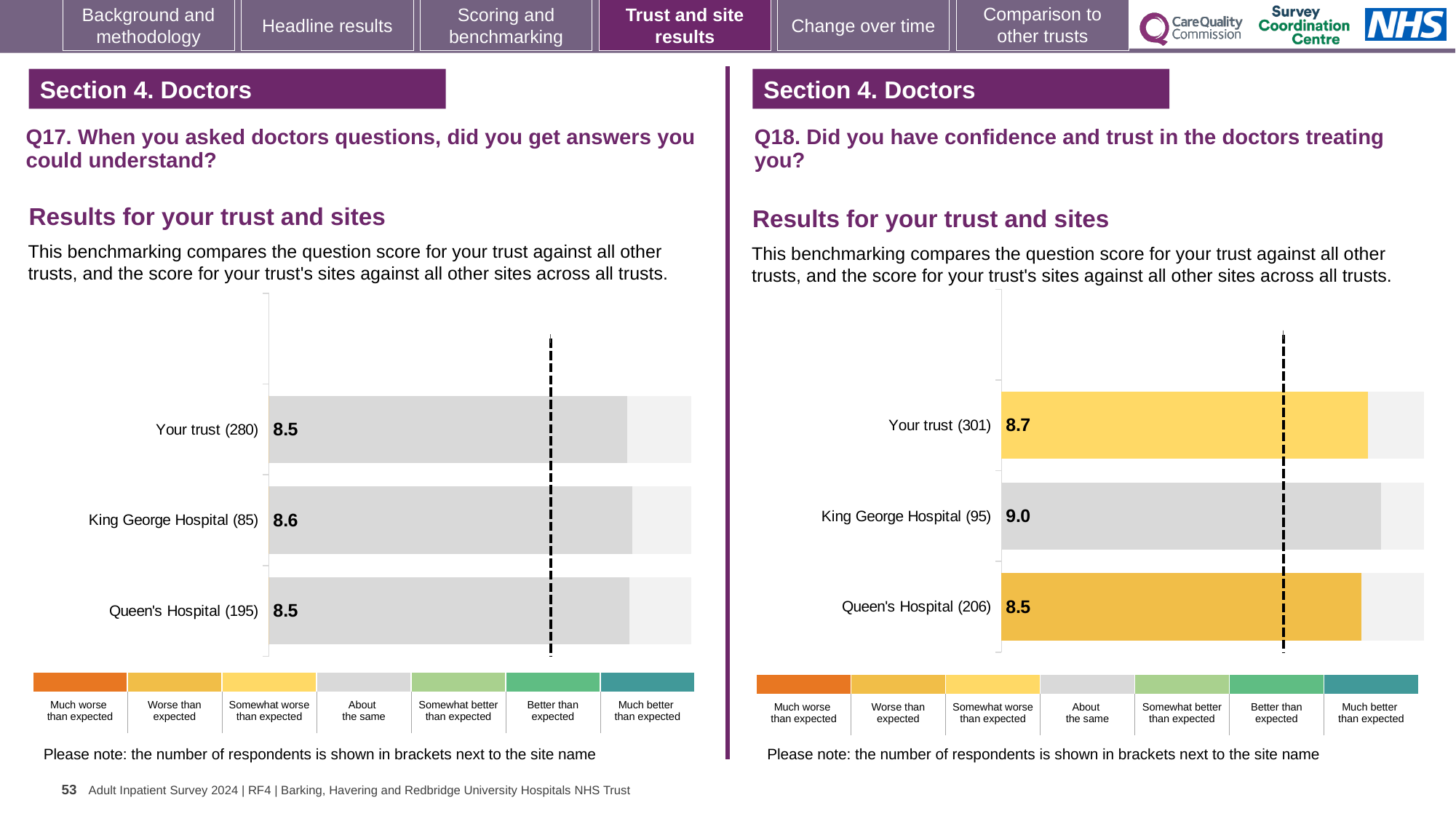
On the Q18 chart (right), what is the difference between the scores for King George Hospital and Queen's Hospital? 0.5 On the Q18 chart (right), which site or trust has the highest score? King George Hospital On the Q17 chart (left), what is the score for King George Hospital? 8.6 On the Q17 chart (left), what is the difference between the scores for King George Hospital and Your trust? 0.1 What kind of chart is used on the Q18 chart (right)? Bar chart On the Q18 chart (right), which has the larger score, Your trust or King George Hospital? King George Hospital On the Q18 chart (right), what is the score for Your trust? 8.7 How many bars are shown on the Q17 chart (left)? 3 On the Q18 chart (right), which site or trust has the lowest score? Queen's Hospital On the Q18 chart (right), how many respondents are shown in brackets for King George Hospital? 95 On the Q18 chart (right), what is the score for Queen's Hospital? 8.5 On the Q17 chart (left), what is the score for Your trust? 8.5